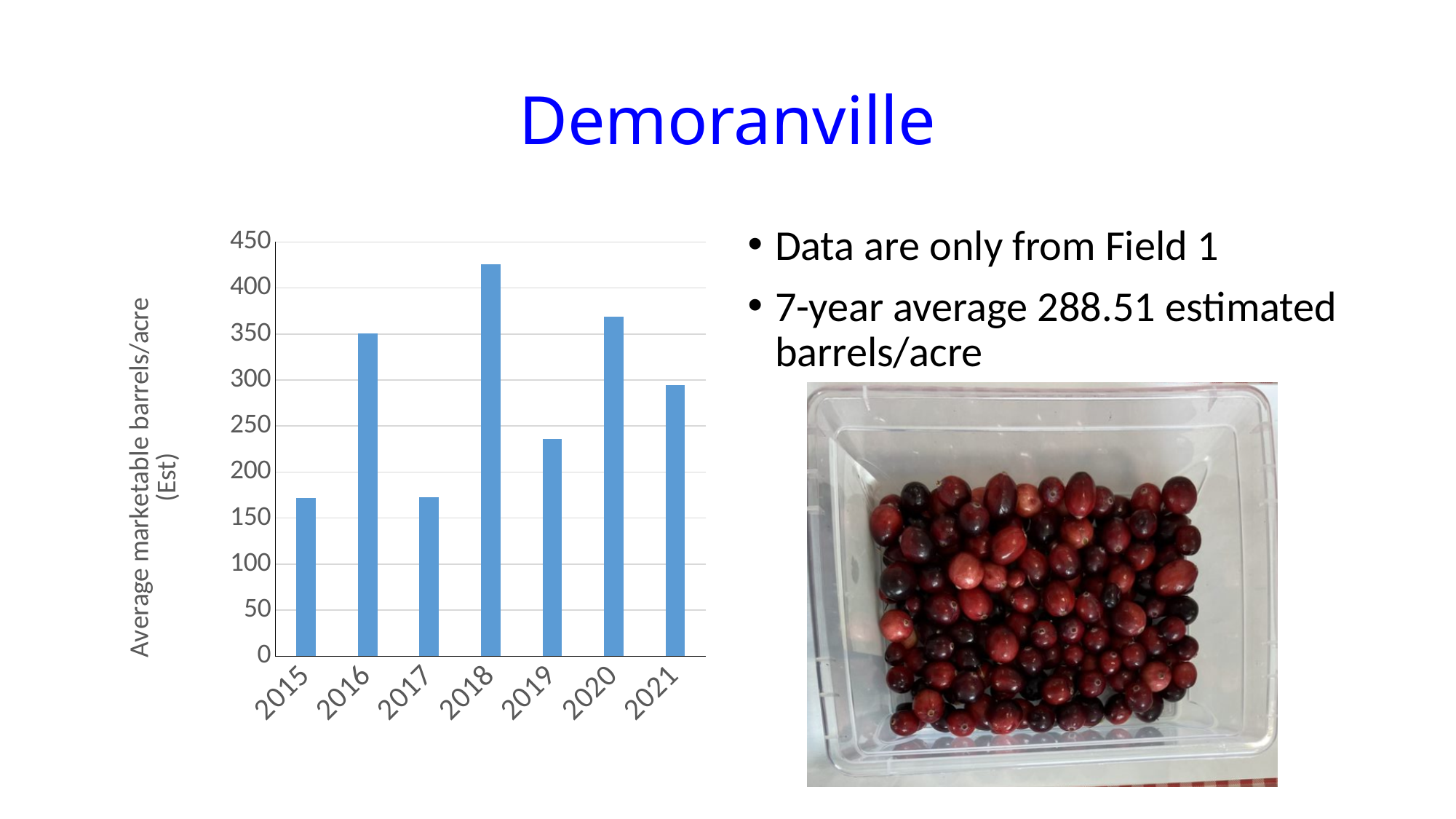
Is the value for 2016 greater or less than 300? greater Is the value for 2019 greater or less than 250? less Which year has the larger value, 2019 or 2021? 2021 Is the value for 2015 greater or less than 200? less How many years are plotted on the x axis of the chart? 7 Which year has the highest average marketable barrels/acre? 2018 What kind of chart is shown on the slide? bar chart Which year has the larger value, 2018 or 2016? 2018 Does the value rise or fall from 2018 to 2019? fall What is the label on the y axis of the chart? Average marketable barrels/acre (Est)